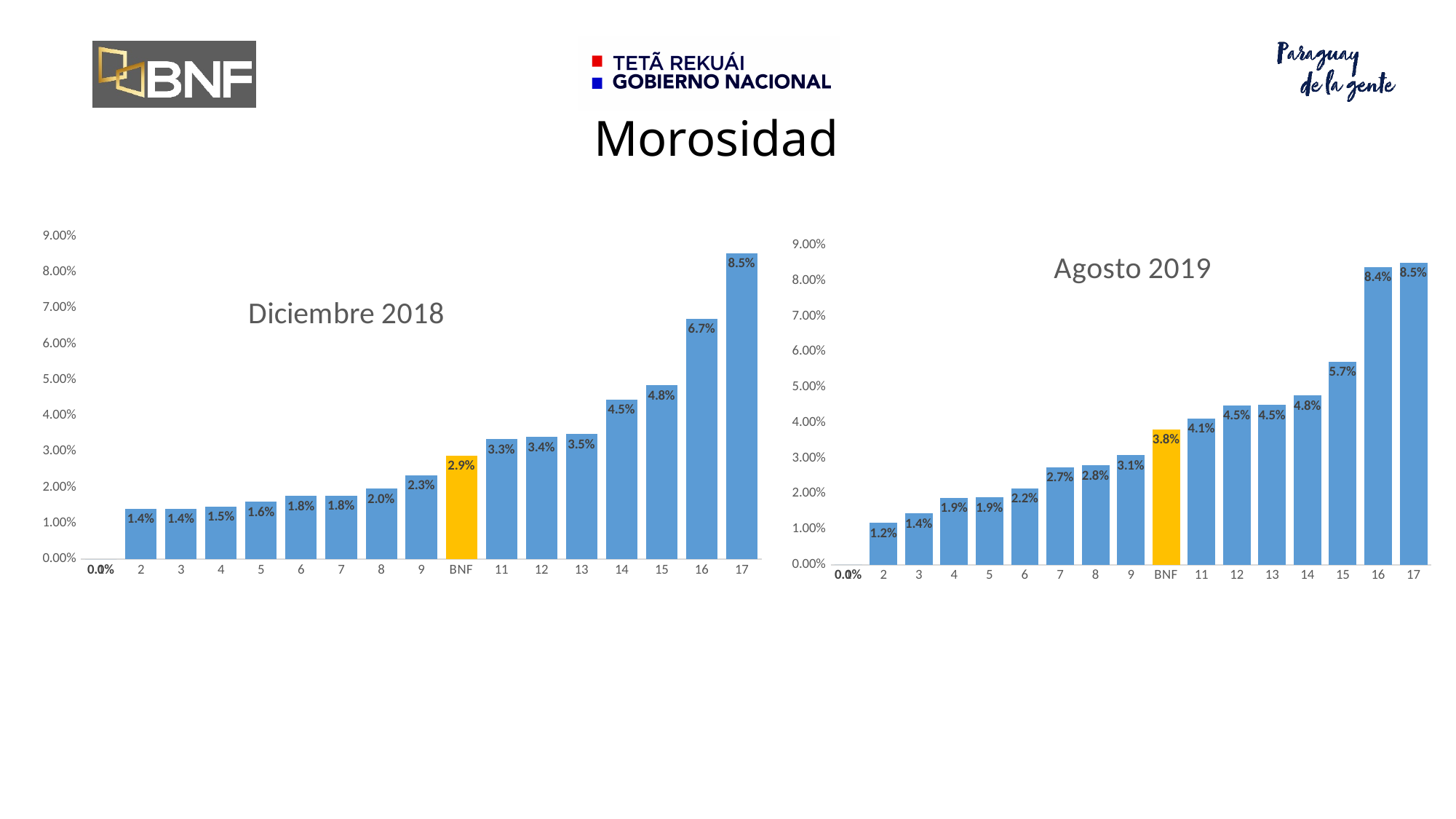
In the Diciembre 2018 chart, which category has the highest value? 17 What kind of chart is the Agosto 2019 chart? bar chart In the Agosto 2019 chart, what is the value for BNF? 3.8% In the Agosto 2019 chart, what is the difference between the values for BNF and category 9? 0.7% In the Diciembre 2018 chart, what is the difference between the values for category 17 and category 16? 1.8% In the Diciembre 2018 chart, which bar is coloured differently (orange) from the others? BNF In the Agosto 2019 chart, is the value for category 15 greater or less than 5.00%? greater In the Diciembre 2018 chart, what is the value for BNF? 2.9% In the Diciembre 2018 chart, do the values rise or fall from left to right along the x axis? rise In the Agosto 2019 chart, what is the value for category 16? 8.4% In the Diciembre 2018 chart, which is larger, the value for category 14 or the value for category 15? 15 In the Agosto 2019 chart, what is the value for category 2? 1.2%